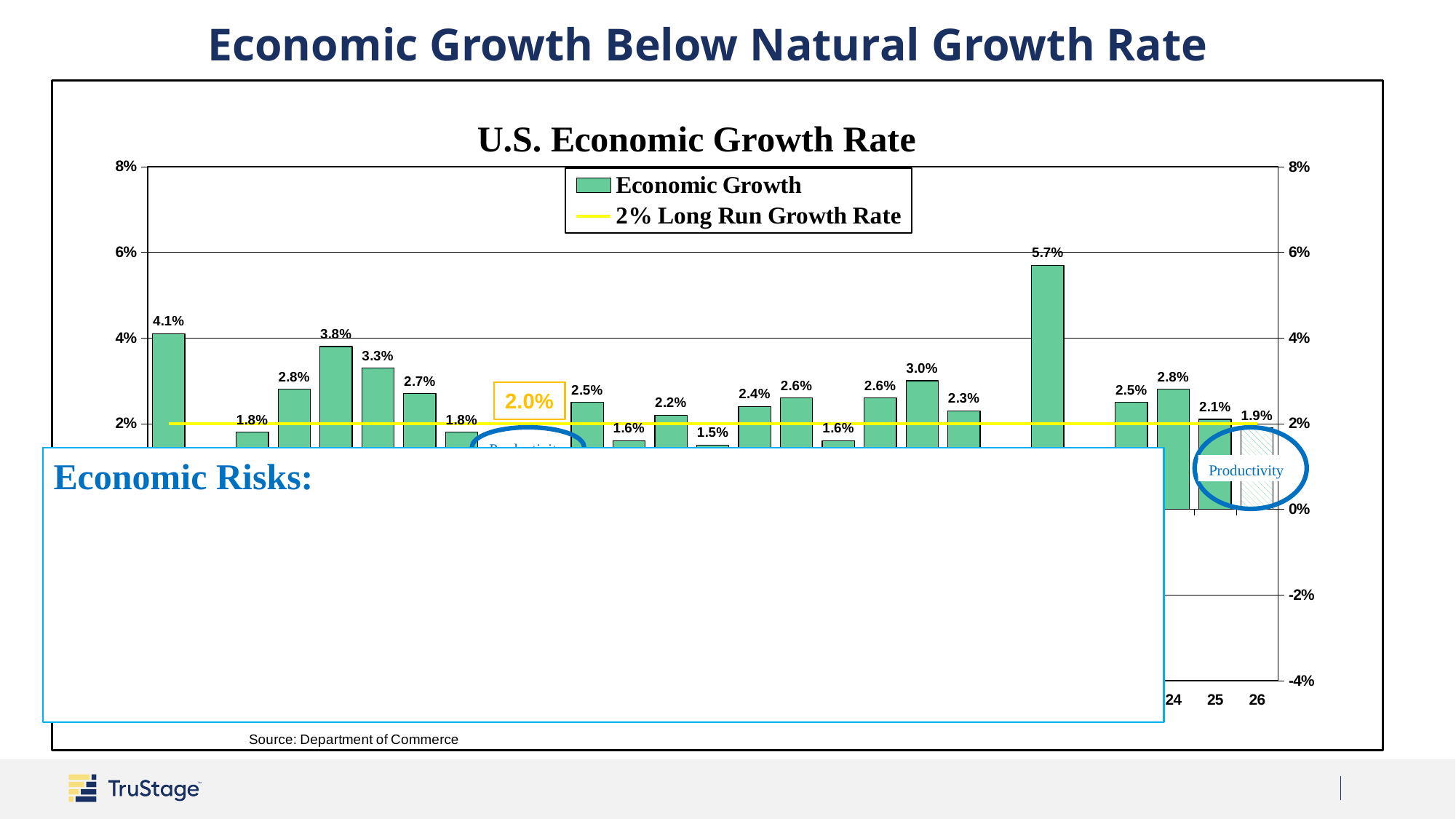
What is the value of the long run growth rate line shown on the chart? 2.0% What is the title of the chart? U.S. Economic Growth Rate Is the economic growth rate for 26 greater or less than the 2% long run growth rate? less How many series does the chart legend list? 2 What is the economic growth rate for 25? 2.1% What is the source cited for the chart? Department of Commerce What is the economic growth rate for 24? 2.8% What type of chart is used to show Economic Growth? Bar chart What is the economic growth rate for 26? 1.9% What is the difference between the economic growth rate for 24 and for 25? 0.7% Which is larger, the economic growth rate for 25 or for 26? 25 What is the highest economic growth rate labeled on the chart? 5.7%